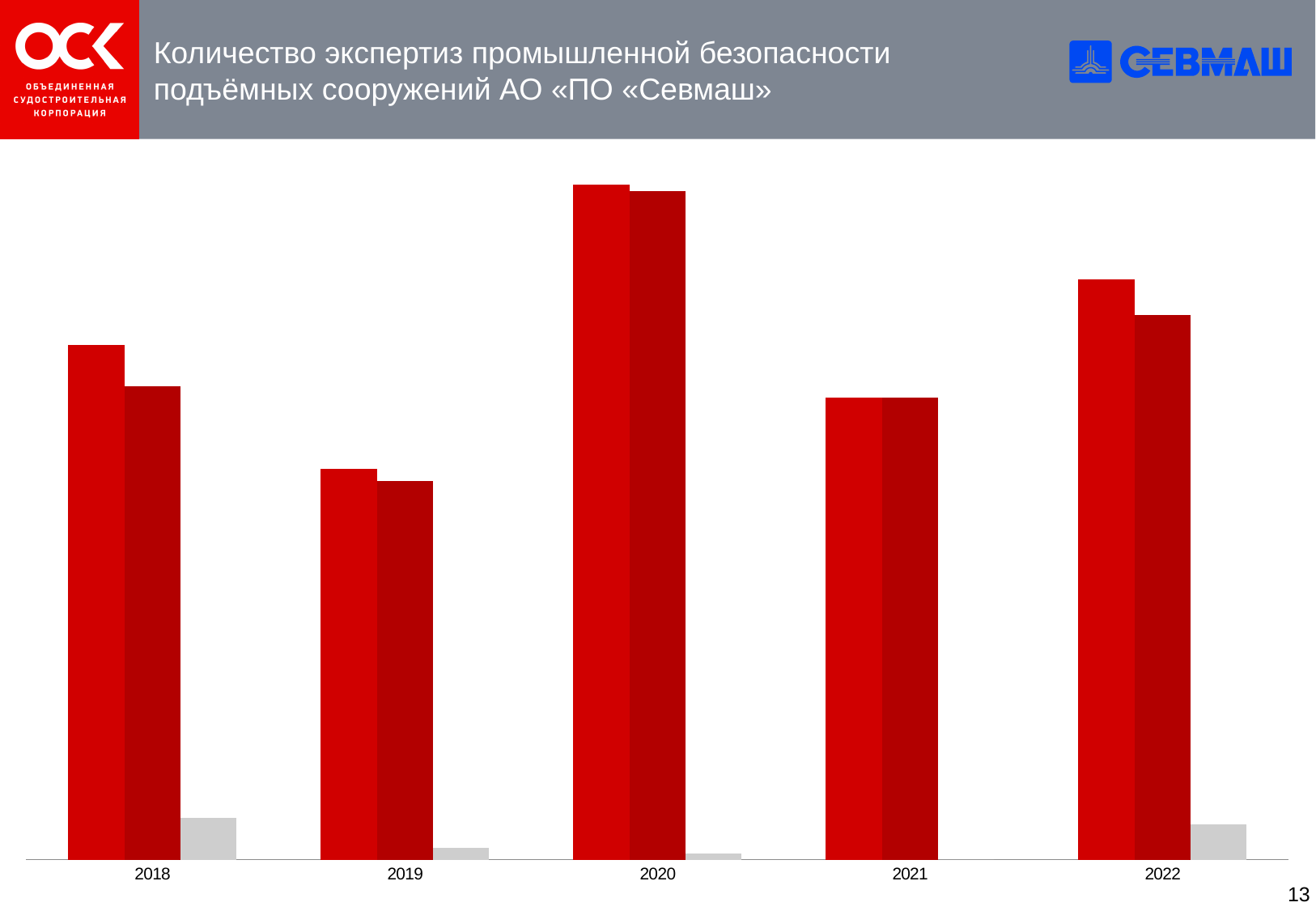
How many years are shown on the x axis of the chart? 5 What is the first year shown on the x axis of the chart? 2018 Which year has the shortest red bar in the chart? 2019 Is the red bar for 2020 taller or shorter than the red bar for 2021? taller Which year has the tallest bars in the chart? 2020 What kind of chart is shown on the slide? bar chart What is the last year shown on the x axis of the chart? 2022 Is the red bar for 2022 taller or shorter than the red bar for 2021? taller How many bars are plotted for each year in the chart? 3 Does the red bar rise or fall from 2019 to 2020? rises Is the red bar for 2018 taller or shorter than the red bar for 2019? taller Does the red bar rise or fall from 2020 to 2021? falls